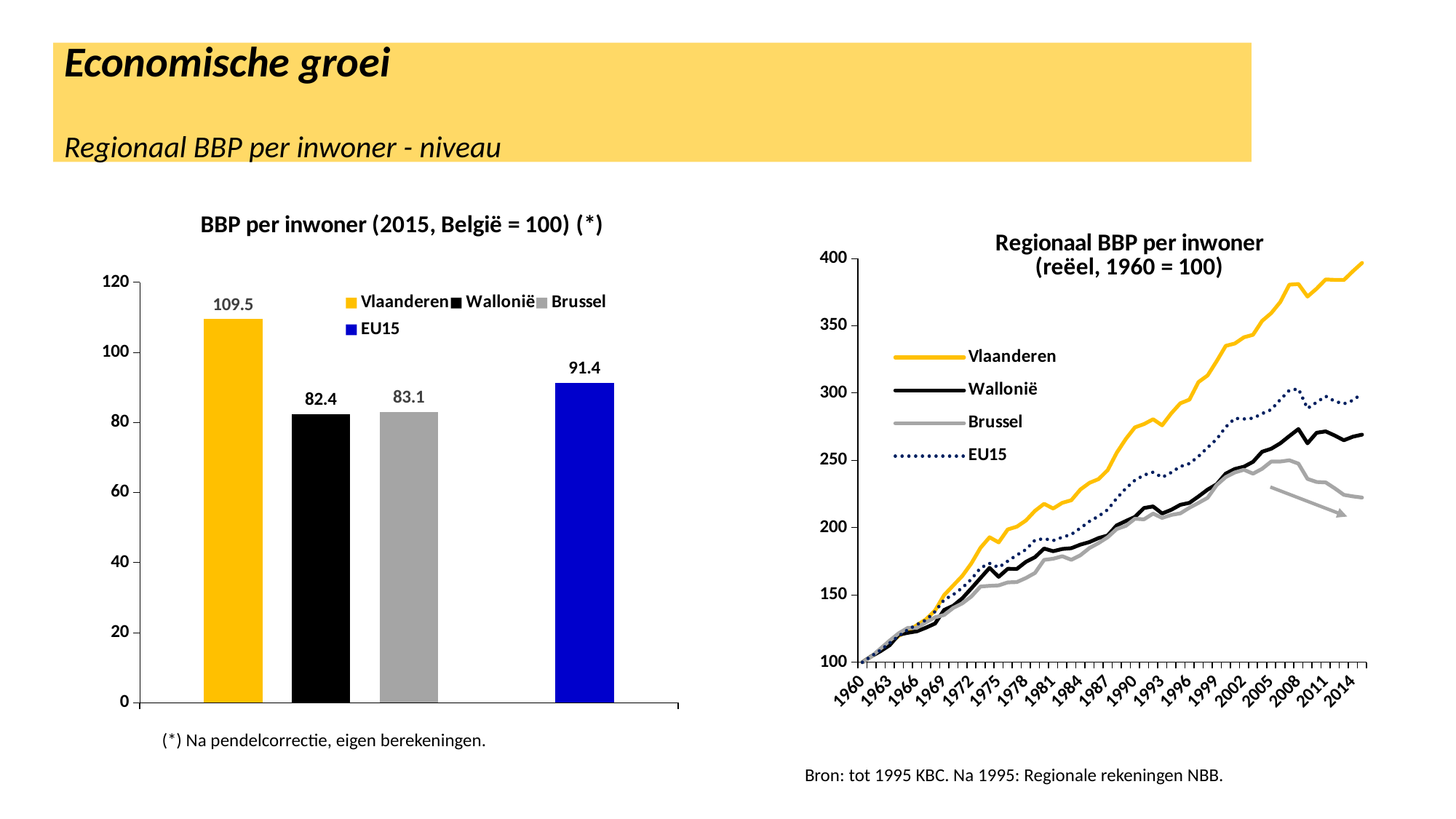
In the chart 'BBP per inwoner (2015, België = 100) (*)', what is the value for Wallonië? 82.4 In the chart 'BBP per inwoner (2015, België = 100) (*)', which region or group has the lowest value? Wallonië In the chart 'Regionaal BBP per inwoner (reëel, 1960 = 100)', how many series does the legend list? 4 In the chart 'Regionaal BBP per inwoner (reëel, 1960 = 100)', is the value for Vlaanderen in 2014 greater or less than 350? greater In the chart 'BBP per inwoner (2015, België = 100) (*)', what is the value for Vlaanderen? 109.5 In the chart 'Regionaal BBP per inwoner (reëel, 1960 = 100)', which series is shown as a dotted line? EU15 In the chart 'BBP per inwoner (2015, België = 100) (*)', which is larger, the value for Brussel or the value for EU15? EU15 In the chart 'BBP per inwoner (2015, België = 100) (*)', what is the value for EU15? 91.4 In the chart 'BBP per inwoner (2015, België = 100) (*)', which region or group has the highest value? Vlaanderen In the chart 'BBP per inwoner (2015, België = 100) (*)', what is the difference between the values for Vlaanderen and EU15? 18.1 In the chart 'BBP per inwoner (2015, België = 100) (*)', how many bars are plotted? 4 What kind of chart is 'BBP per inwoner (2015, België = 100) (*)'? Bar chart